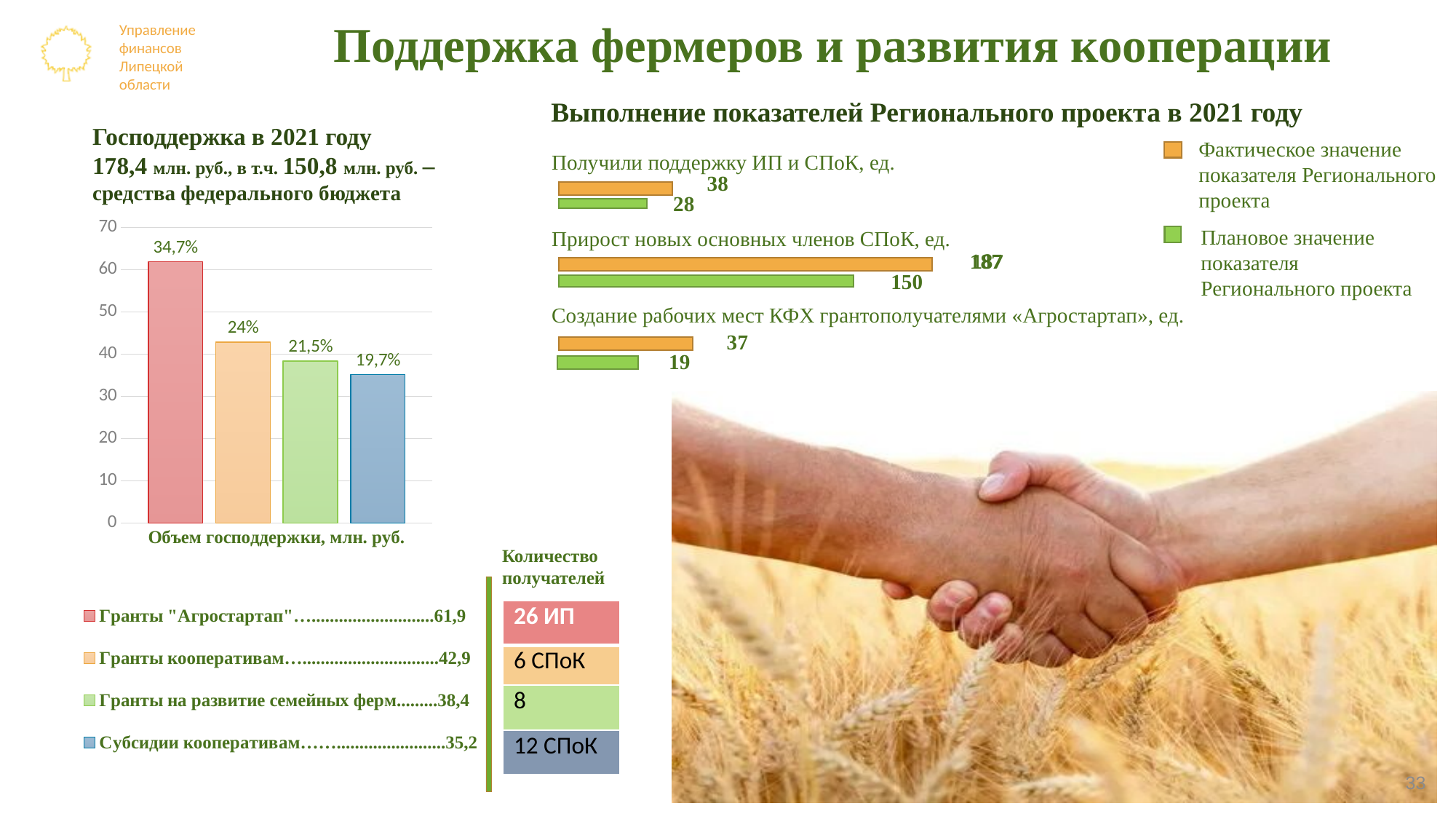
In the chart "Выполнение показателей Регионального проекта в 2021 году", by how much does the actual value for Получили поддержку ИП и СПоК exceed the planned value? 10 In the chart "Объем господдержки, млн. руб.", what is the difference in percentage points between the labels for Гранты "Агростартап" (34,7%) and Субсидии кооперативам (19,7%)? 15 In the chart "Объем господдержки, млн. руб.", is the bar for Гранты кооперативам greater or less than 40? greater In the chart "Выполнение показателей Регионального проекта в 2021 году", what is the actual value (Фактическое значение) for Прирост новых основных членов СПоК? 187 In the chart "Объем господдержки, млн. руб.", what value does the legend give for Гранты на развитие семейных ферм? 38,4 How many bars are plotted in the chart "Объем господдержки, млн. руб."? 4 What kind of chart is the chart titled "Объем господдержки, млн. руб." on the left of the slide? bar chart In the chart "Объем господдержки, млн. руб.", what percentage label is shown above the bar for Гранты "Агростартап"? 34,7% How many series does the legend of the chart "Выполнение показателей Регионального проекта в 2021 году" list? 2 In the chart "Выполнение показателей Регионального проекта в 2021 году", what is the planned value (Плановое значение) for Создание рабочих мест КФХ грантополучателями «Агростартап»? 19 In the chart "Объем господдержки, млн. руб.", which category has the tallest bar? Гранты "Агростартап" In the chart "Объем господдержки, млн. руб.", which category has the shortest bar? Субсидии кооперативам